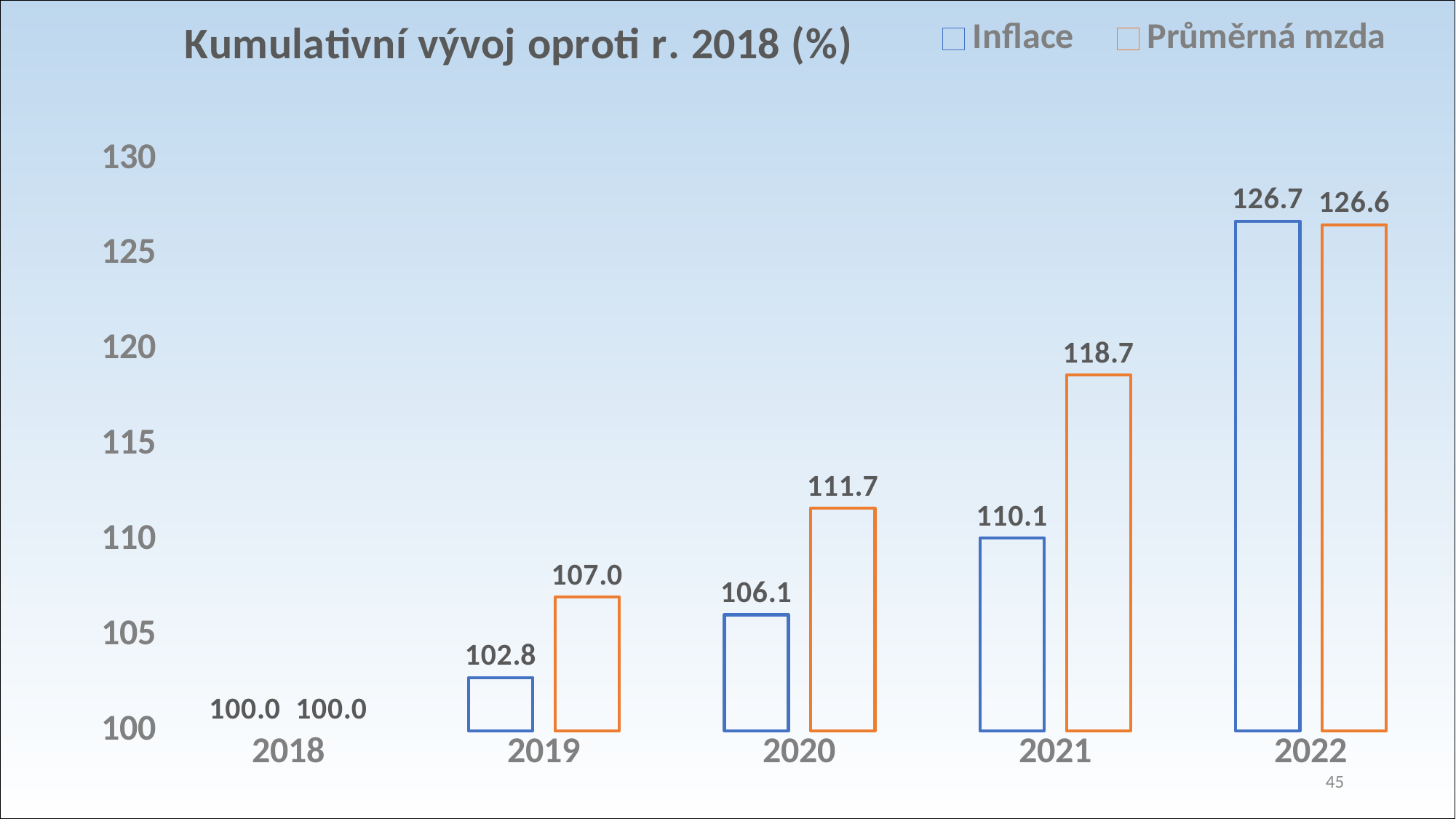
How many series does the legend list? 2 What is the Inflace value for 2021? 110.1 How many years are shown on the x axis? 5 Which is larger in 2020, Inflace or Průměrná mzda? Průměrná mzda What is the difference between Průměrná mzda and Inflace in 2021? 8.6 What is the Průměrná mzda value for 2020? 111.7 What kind of chart is shown? bar chart In which year is the Inflace value lowest? 2018 What is the Inflace value for 2019? 102.8 In which year is the Průměrná mzda value highest? 2022 What is the title of the chart? Kumulativní vývoj oproti r. 2018 (%) Do the Inflace values rise or fall from 2018 to 2022? rise